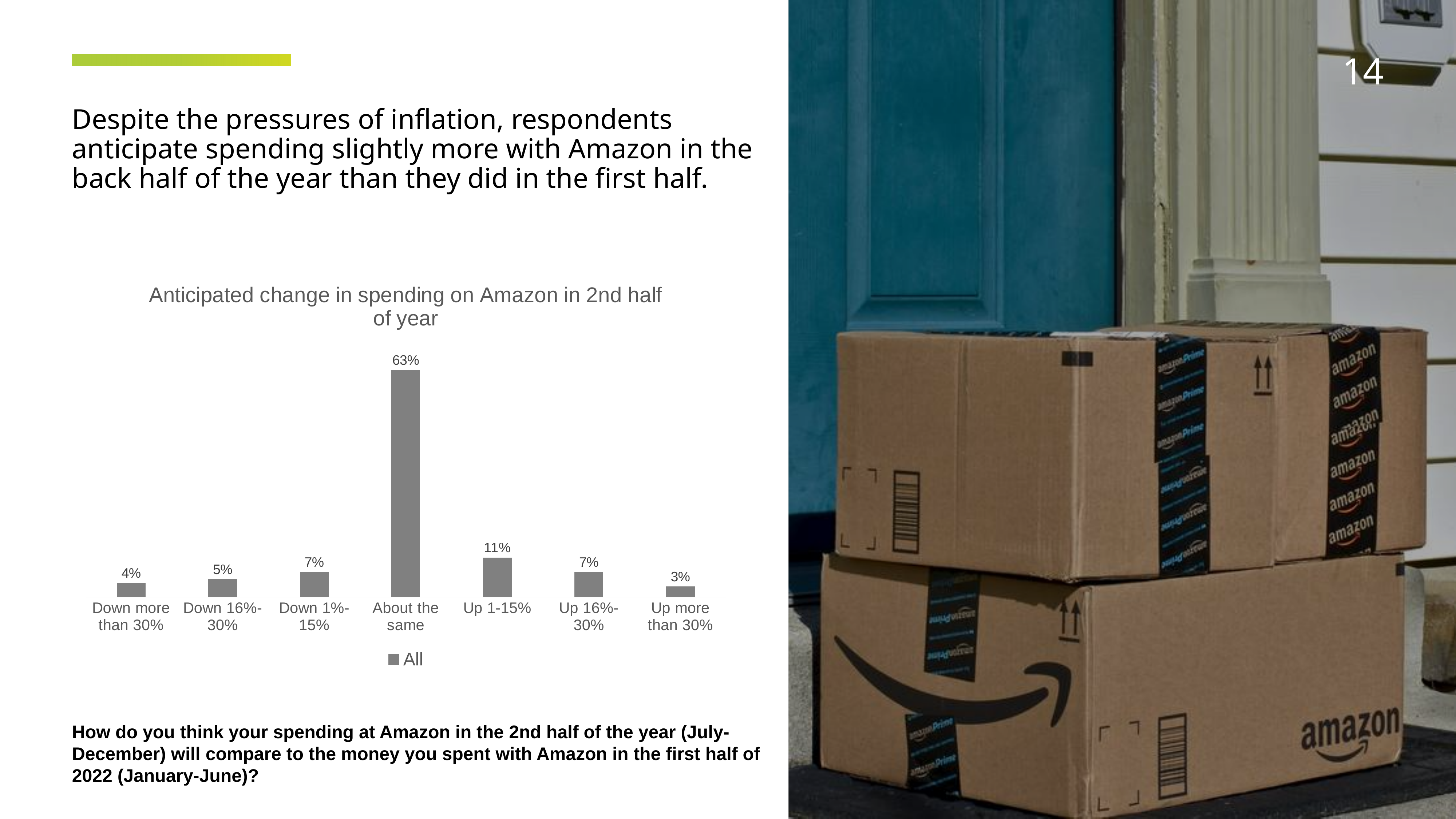
How many series does the legend list? 1 What is the title of the chart? Anticipated change in spending on Amazon in 2nd half of year What is the difference between the 'About the same' value and the 'Up 1-15%' value? 52% How many categories are shown on the x axis? 7 What percentage of respondents anticipate spending about the same on Amazon in the 2nd half of the year? 63% Which is larger, the value for 'Down 16%-30%' or the value for 'Up 16%-30%'? Up 16%-30% Which category has the highest value? About the same What is the value for 'Down more than 30%'? 4% What is the value for 'Up more than 30%'? 3% What kind of chart is shown on the slide? Bar chart What is the value for the 'Up 1-15%' category? 11% Which category has the lowest value? Up more than 30%